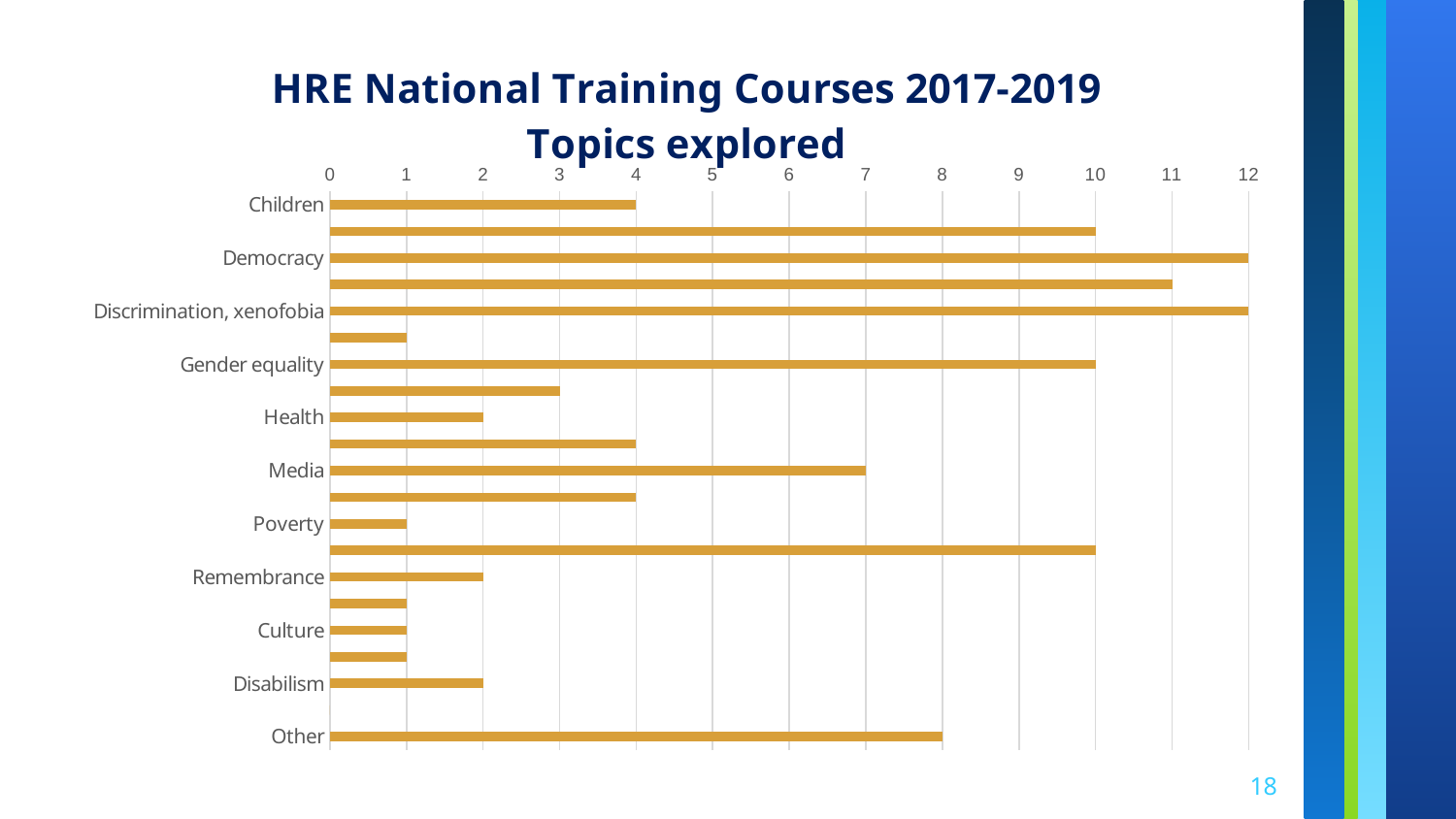
Is the value for Other greater or less than 5? greater What is the value for Children? 4 Which has the larger value, Media or Other? Other What kind of chart is shown on the slide? bar chart What is the difference between the values for Democracy and Children? 8 Which has the larger value, Gender equality or Health? Gender equality What is the highest value shown on the horizontal axis? 12 What is the value for Gender equality? 10 What is the value for Health? 2 What is the value for Democracy? 12 What is the value for Media? 7 What is the value for Other? 8